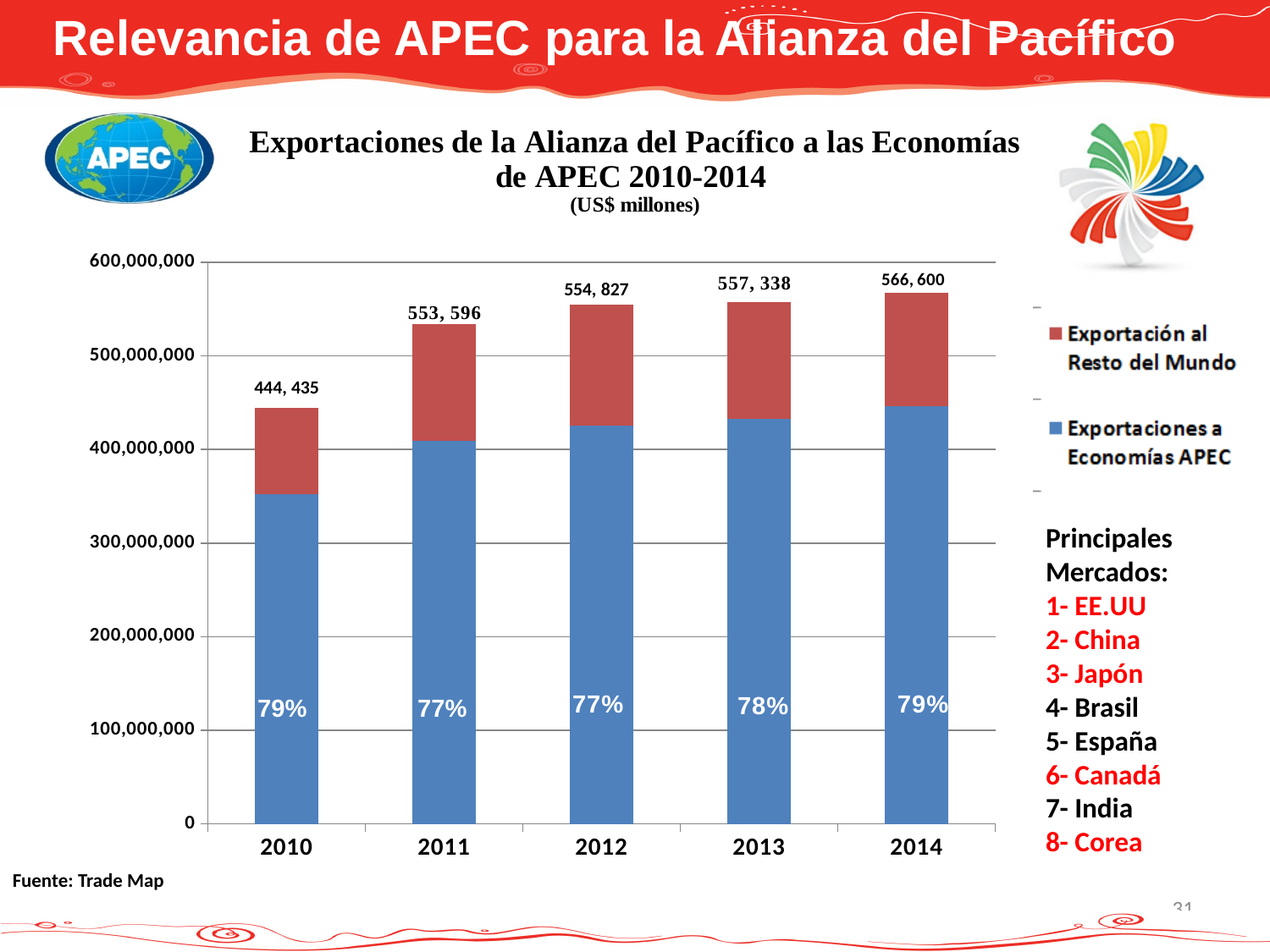
How many series does the chart legend list? 2 What is the total value labelled above the bar for 2010? 444, 435 What percentage is printed inside the blue segment for 2013? 78% Which year has the larger labelled total, 2011 or 2012? 2012 What is the total value labelled above the bar for 2014? 566, 600 What is the difference between the total labelled for 2014 and the total labelled for 2010? 122,165 What kind of chart is shown on the slide? bar chart Do the labelled totals rise or fall from 2010 to 2014? rise How many years are shown on the x axis of the chart? 5 Which year has the highest total labelled above its bar? 2014 Is the value of the blue segment (Exportaciones a Economías APEC) for 2010 greater or less than 400,000,000? less Which year has the lowest total labelled above its bar? 2010